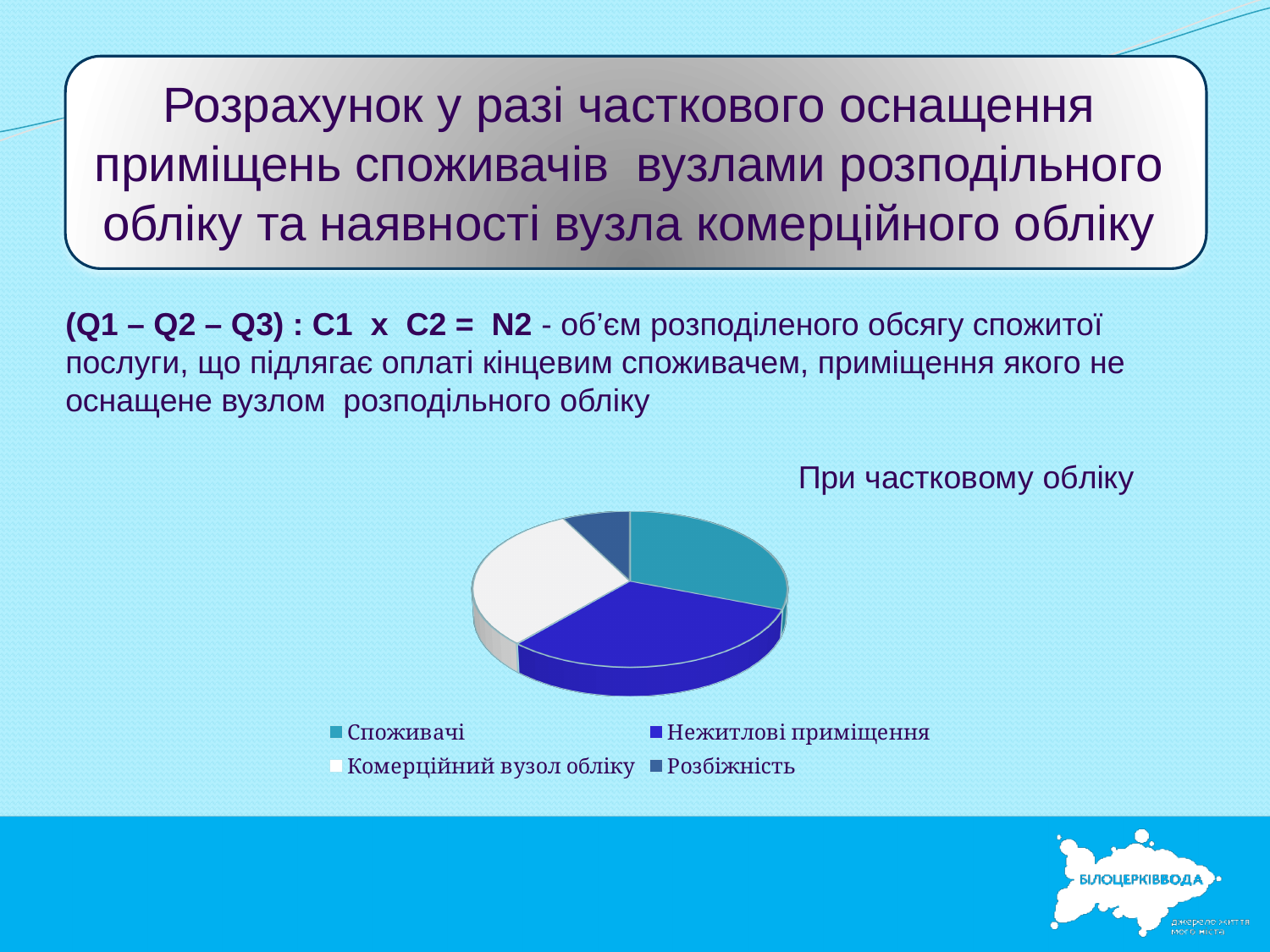
How many slices does the pie chart have? 4 What is the title shown above the pie chart? При частковому обліку Which slice is larger: Комерційний вузол обліку or Розбіжність? Комерційний вузол обліку Which category has the smallest slice in the pie chart? Розбіжність Which category is shown in white in the pie chart? Комерційний вузол обліку Which slice is larger: Споживачі or Розбіжність? Споживачі How many entries does the legend of the pie chart list? 4 What kind of chart is shown on the slide? pie chart Which slice is larger: Нежитлові приміщення or Розбіжність? Нежитлові приміщення